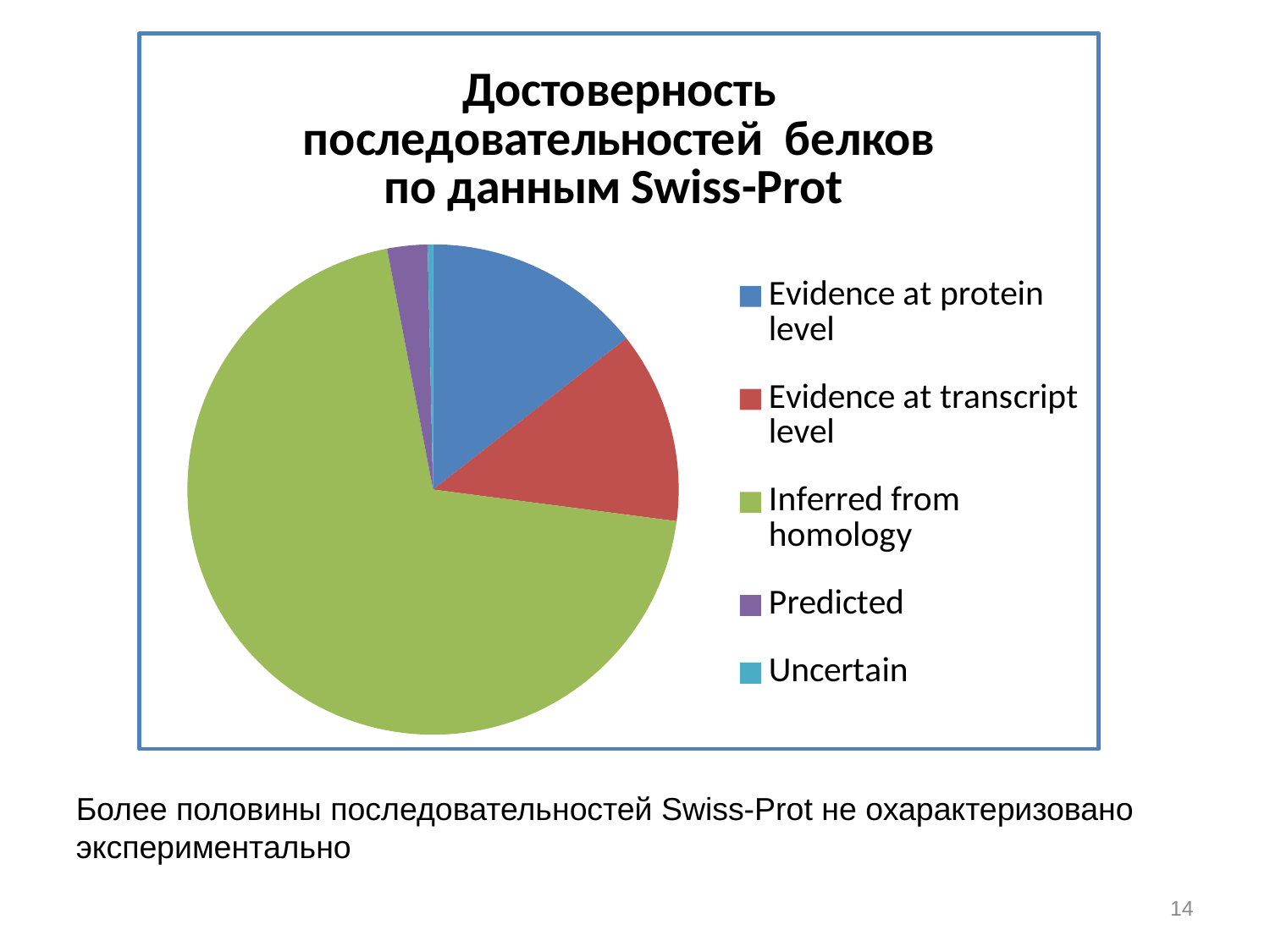
Which slice is larger: Evidence at protein level or Predicted? Evidence at protein level How many categories (slices) does the pie chart have? 5 What kind of chart is shown on the slide? pie chart Is the share of the pie for Inferred from homology greater or less than 50%? greater Which slice is larger: Evidence at transcript level or Uncertain? Evidence at transcript level How many entries does the legend of the pie chart list? 5 What is the title of the pie chart? Достоверность последовательностей белков по данным Swiss-Prot Which category has the smallest slice of the pie chart? Uncertain Which slice is larger: Predicted or Uncertain? Predicted What colour is the Inferred from homology slice in the pie chart? green Which category has the largest slice of the pie chart? Inferred from homology